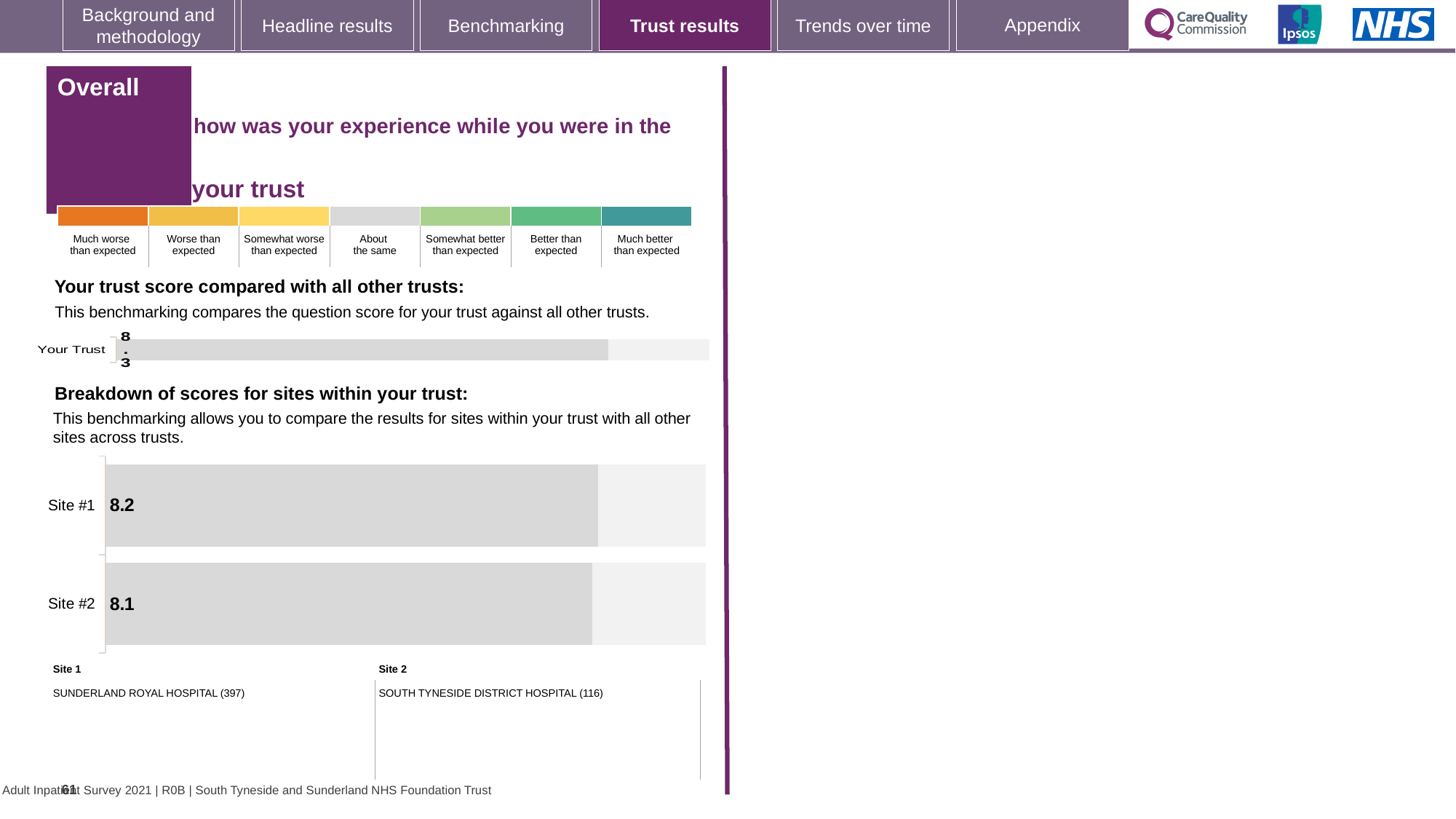
What type of chart is used in the 'Breakdown of scores for sites within your trust' section? Bar chart In the 'Breakdown of scores for sites within your trust' chart, what is the score for Site #1? 8.2 In the 'Breakdown of scores for sites within your trust' chart, how many sites are shown? 2 In the 'Your trust score compared with all other trusts' chart, what is the score for Your Trust? 8.3 In the 'Your trust score compared with all other trusts' chart, how many bars are plotted? 1 Is the Your Trust score in the 'Your trust score compared with all other trusts' chart larger than the Site #2 score in the breakdown chart? Yes According to the site key below the breakdown chart, which hospital is Site 2? SOUTH TYNESIDE DISTRICT HOSPITAL (116) In the 'Breakdown of scores for sites within your trust' chart, which site has the higher score? Site #1 In the 'Breakdown of scores for sites within your trust' chart, which site has the lower score? Site #2 In the 'Breakdown of scores for sites within your trust' chart, what is the difference between the scores of Site #1 and Site #2? 0.1 In the 'Breakdown of scores for sites within your trust' chart, what is the score for Site #2? 8.1 According to the site key below the breakdown chart, which hospital is Site 1? SUNDERLAND ROYAL HOSPITAL (397)